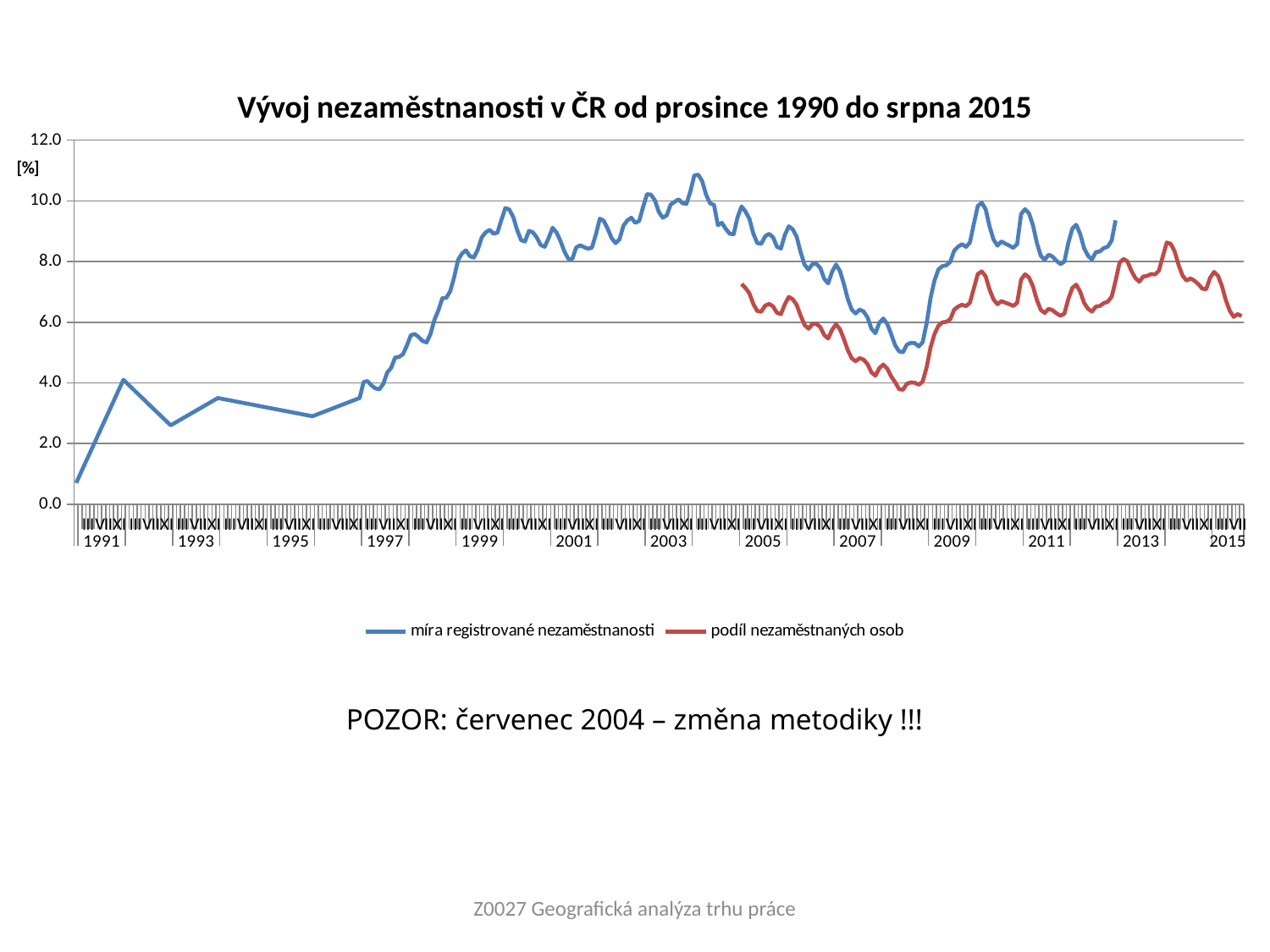
Which series is drawn in red? podíl nezaměstnaných osob Is the peak value of the 'míra registrované nezaměstnanosti' line around 2003–2004 greater or less than 10.0? greater Does the 'míra registrované nezaměstnanosti' line overall rise or fall between 1991 and 1999? rise Which series reaches the higher peak value over the whole chart, 'míra registrované nezaměstnanosti' or 'podíl nezaměstnaných osob'? míra registrované nezaměstnanosti Does the 'podíl nezaměstnaných osob' line rise or fall from its 2013 peak to the end of the chart in 2015? fall Is the value of the 'podíl nezaměstnaných osob' line at its start in 2004 greater or less than 6.0? greater What kind of chart is shown on the slide? line chart What is the title of the chart? Vývoj nezaměstnanosti v ČR od prosince 1990 do srpna 2015 How many series does the legend list? 2 Is the first value of the 'míra registrované nezaměstnanosti' line at the start of the chart greater or less than 2.0? less